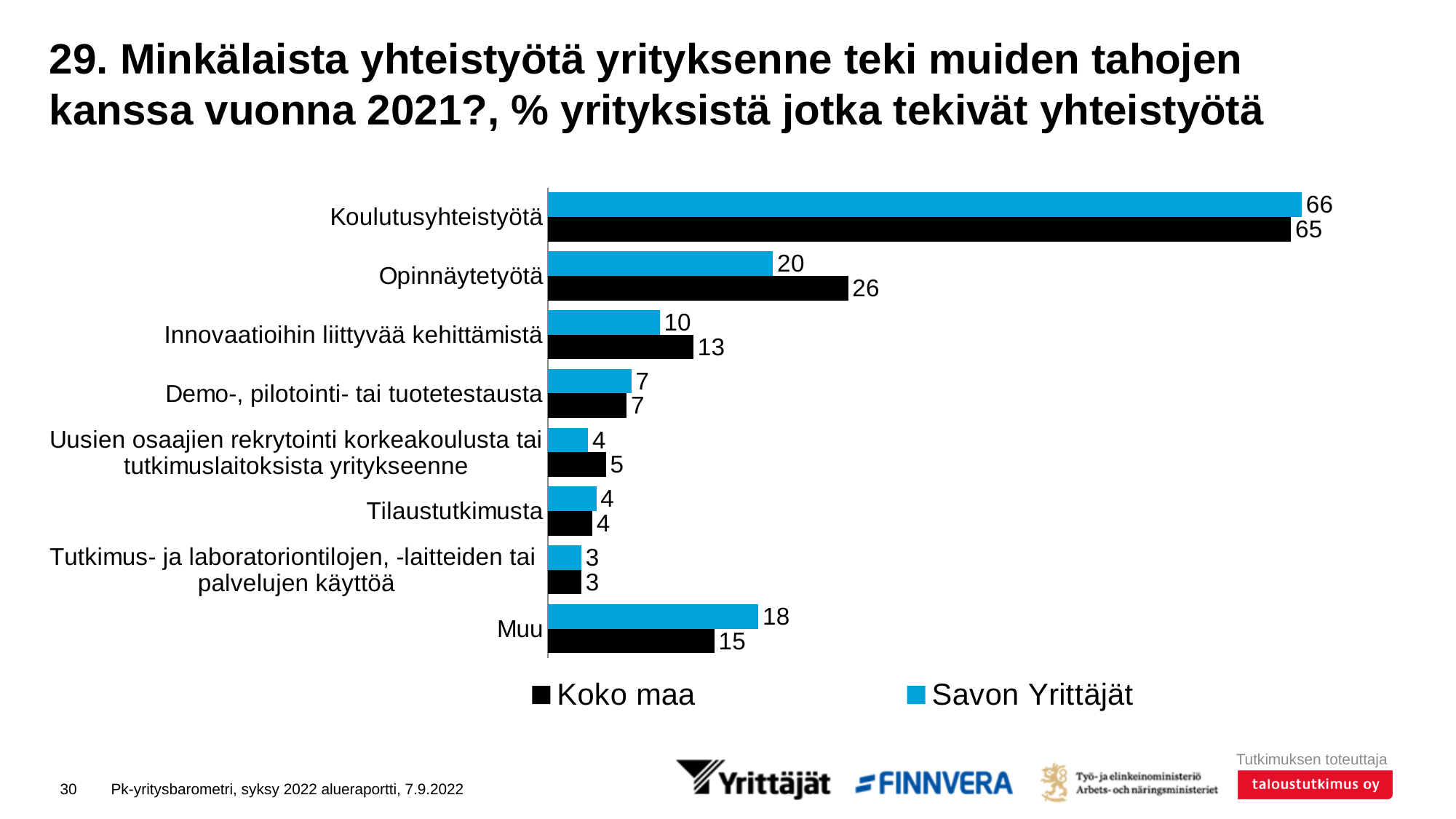
What kind of chart is shown on the slide? Bar chart For Muu, which series has the larger value, Koko maa or Savon Yrittäjät? Savon Yrittäjät Which category has the highest value in the Koko maa series? Koulutusyhteistyötä What is the value for Koulutusyhteistyötä in the Savon Yrittäjät series? 66 What is the difference between the Koko maa and Savon Yrittäjät values for Opinnäytetyötä? 6 Which colour represents the Savon Yrittäjät series? Blue For Innovaatioihin liittyvää kehittämistä, which series has the larger value, Koko maa or Savon Yrittäjät? Koko maa How many series does the legend list? 2 What is the value for Muu in the Savon Yrittäjät series? 18 What is the value for Opinnäytetyötä in the Koko maa series? 26 How many categories are shown in the chart? 8 Which category has the lowest value in the Savon Yrittäjät series? Tutkimus- ja laboratoriontilojen, -laitteiden tai palvelujen käyttöä